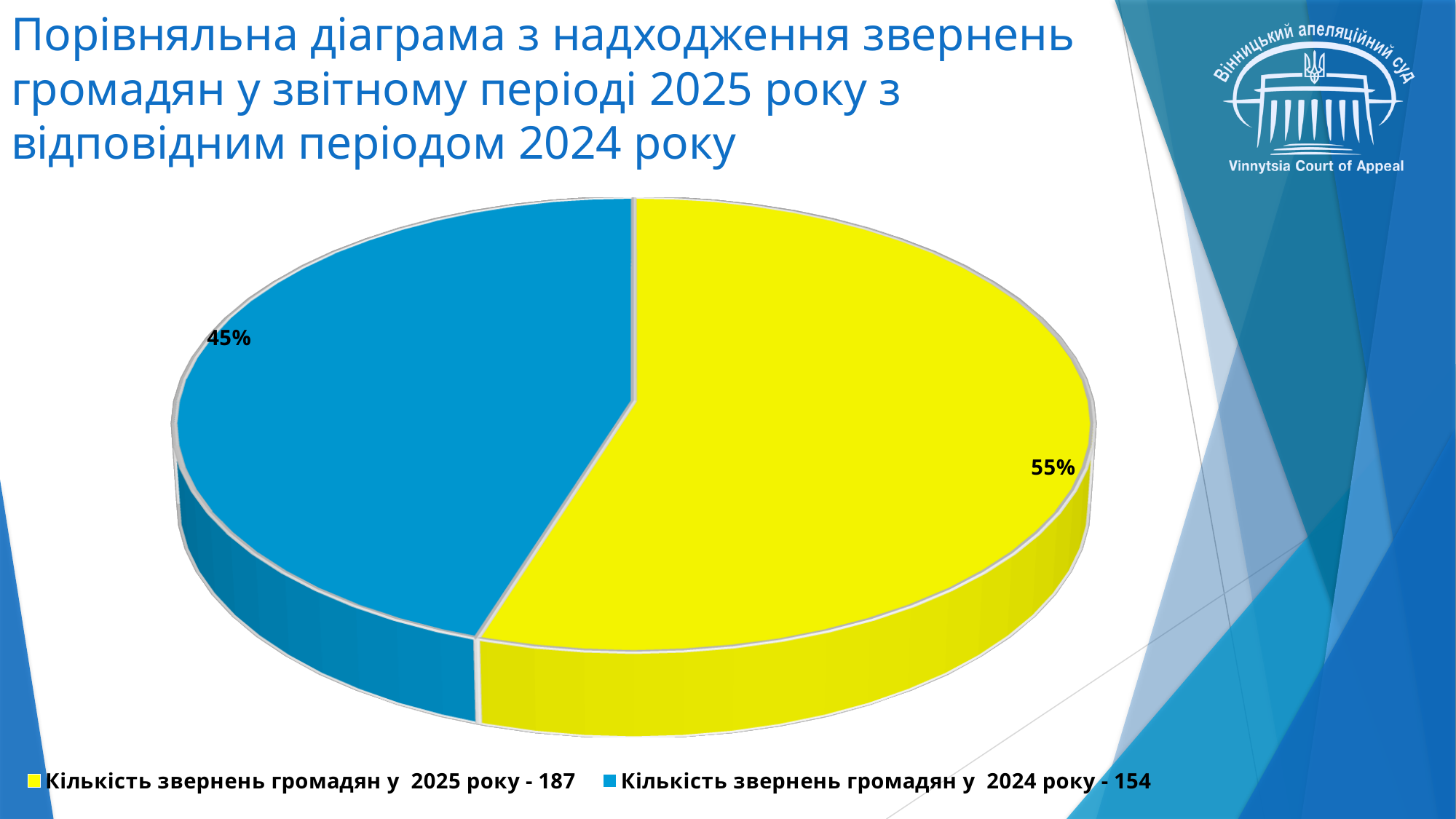
What share of the pie is the yellow slice (appeals in 2025)? 55% How many slices does the pie chart have? 2 According to the legend, how many citizen appeals were received in 2025? 187 What share of the pie is the blue slice (appeals in 2024)? 45% According to the legend, how many citizen appeals were received in 2024? 154 Which colour represents the appeals received in 2024? blue Which year has the larger slice of the pie, 2025 or 2024? 2025 What kind of chart is shown on the slide? pie chart What is the difference between the number of appeals in 2025 and in 2024? 33 What is the difference in percentage points between the 2025 slice and the 2024 slice? 10% Which year has the smallest share of the pie? 2024 How many entries does the legend list? 2